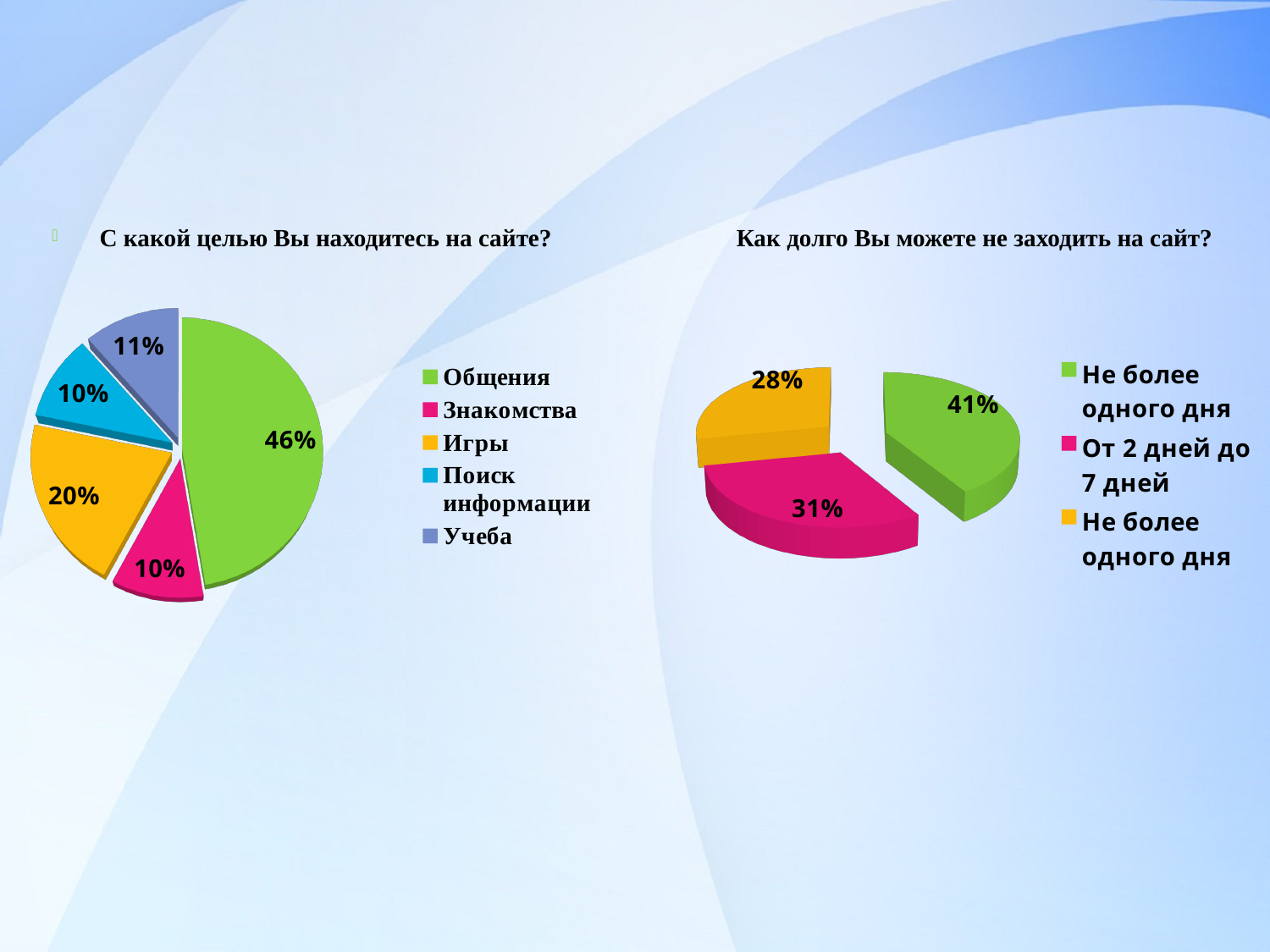
In the right chart 'Как долго Вы можете не заходить на сайт?', how many slices does the pie have? 3 In the left chart 'С какой целью Вы находитесь на сайте?', what percentage is shown for Общения? 46% In the right chart 'Как долго Вы можете не заходить на сайт?', what percentage is shown for От 2 дней до 7 дней? 31% In the right chart 'Как долго Вы можете не заходить на сайт?', what percentage is shown on the green slice? 41% What type of chart is the left chart 'С какой целью Вы находитесь на сайте?'? Pie chart In the left chart 'С какой целью Вы находитесь на сайте?', how many categories does the legend list? 5 In the left chart 'С какой целью Вы находитесь на сайте?', what percentage is shown for Игры? 20% In the left chart 'С какой целью Вы находитесь на сайте?', which is larger, Игры or Учеба? Игры In the left chart 'С какой целью Вы находитесь на сайте?', what is the difference in percentage points between Общения and Игры? 26 In the left chart 'С какой целью Вы находитесь на сайте?', which category has the largest share? Общения In the left chart 'С какой целью Вы находитесь на сайте?', what percentage is shown for Учеба? 11% In the right chart 'Как долго Вы можете не заходить на сайт?', what is the difference in percentage points between the green slice (41%) and the orange slice (28%)? 13